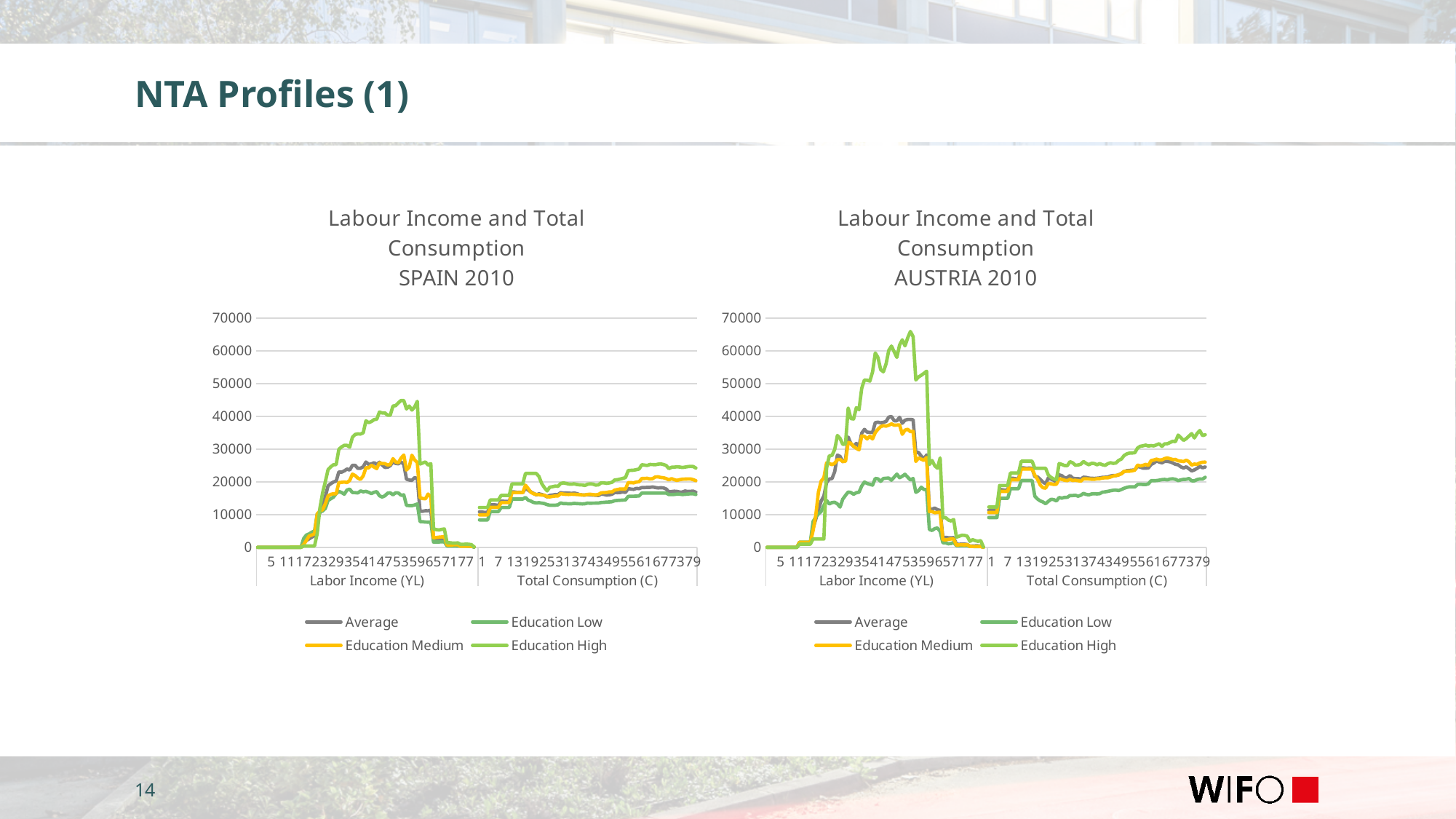
In the 'Labour Income and Total Consumption SPAIN 2010' chart, is the peak value of Education High in the Labor Income (YL) section greater or less than 40000? greater What are the two sections labelled on the horizontal axis of the 'Labour Income and Total Consumption AUSTRIA 2010' chart? Labor Income (YL) and Total Consumption (C) Comparing the peak Labor Income (YL) of Education High in the SPAIN 2010 chart and the AUSTRIA 2010 chart, which is higher? AUSTRIA 2010 How many series does the legend of the 'Labour Income and Total Consumption AUSTRIA 2010' chart list? 4 In the 'Labour Income and Total Consumption AUSTRIA 2010' chart, is the peak value of Education High in the Labor Income (YL) section greater or less than 60000? greater In the 'Labour Income and Total Consumption SPAIN 2010' chart, which series reaches the highest peak in the Labor Income (YL) section? Education High What is the highest value shown on the vertical axis of the 'Labour Income and Total Consumption SPAIN 2010' chart? 70000 In the 'Labour Income and Total Consumption AUSTRIA 2010' chart, is the peak value of Education Low in the Labor Income (YL) section greater or less than 30000? less In the 'Labour Income and Total Consumption AUSTRIA 2010' chart, which series reaches the highest peak in the Labor Income (YL) section? Education High In the 'Labour Income and Total Consumption AUSTRIA 2010' chart, which series has the lowest values in the Total Consumption (C) section? Education Low What kind of chart is the 'Labour Income and Total Consumption SPAIN 2010' chart? line chart